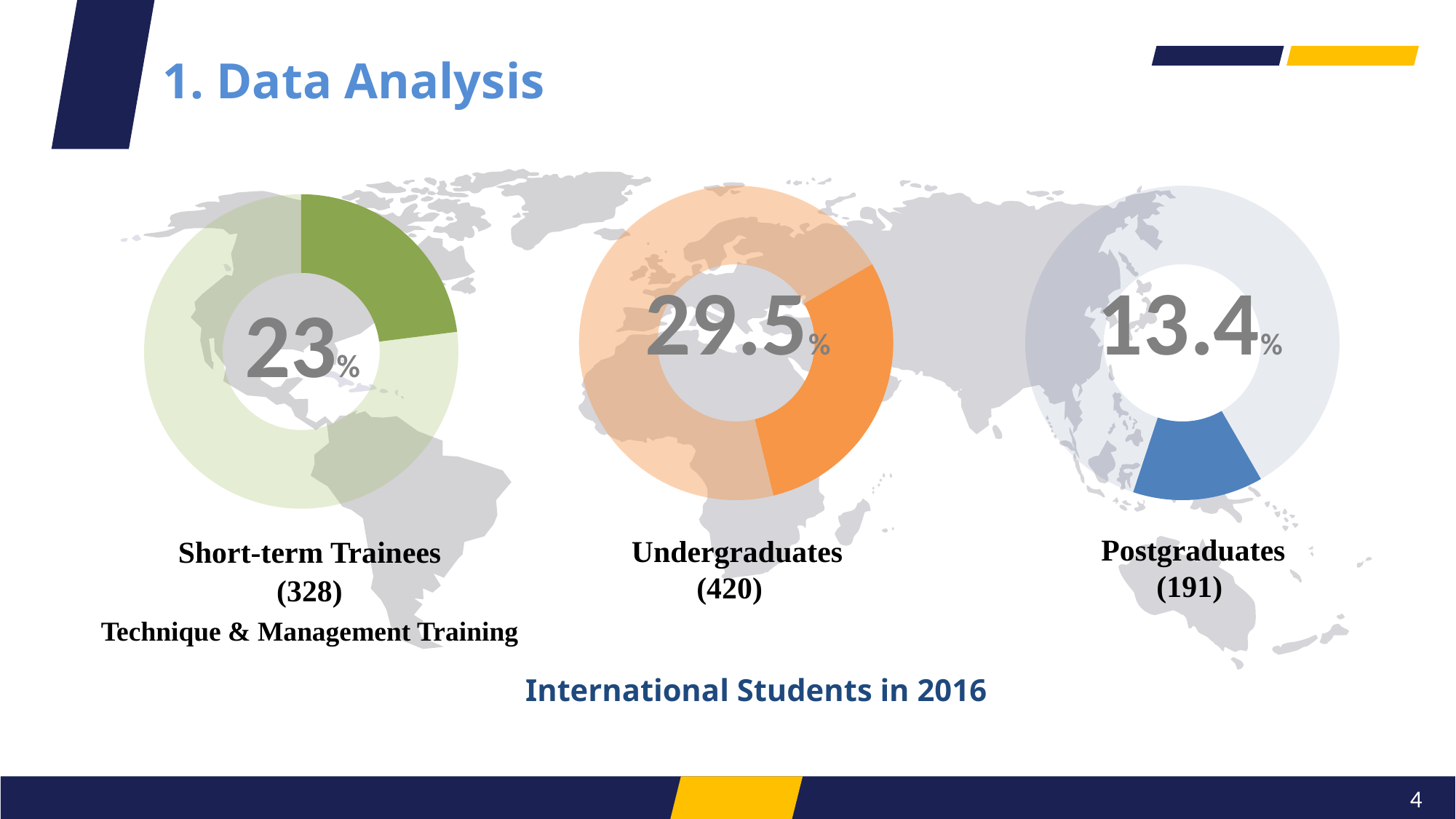
What percentage is shown in the Undergraduates donut chart? 29.5% Which of the three donut charts shows the highest percentage? Undergraduates What is the difference in percentage points between the Undergraduates chart and the Postgraduates chart? 16.1 How many donut charts are shown on the slide? 3 What count is given in parentheses under the Postgraduates chart? 191 What count is given in parentheses under the Short-term Trainees chart? 328 What percentage is shown in the Short-term Trainees donut chart? 23% What count is given in parentheses under the Undergraduates chart? 420 What type of chart is used to show each student group on this slide? Donut chart Which of the three donut charts shows the lowest percentage? Postgraduates Which is larger, the percentage in the Short-term Trainees chart or the percentage in the Postgraduates chart? Short-term Trainees What percentage is shown in the Postgraduates donut chart? 13.4%